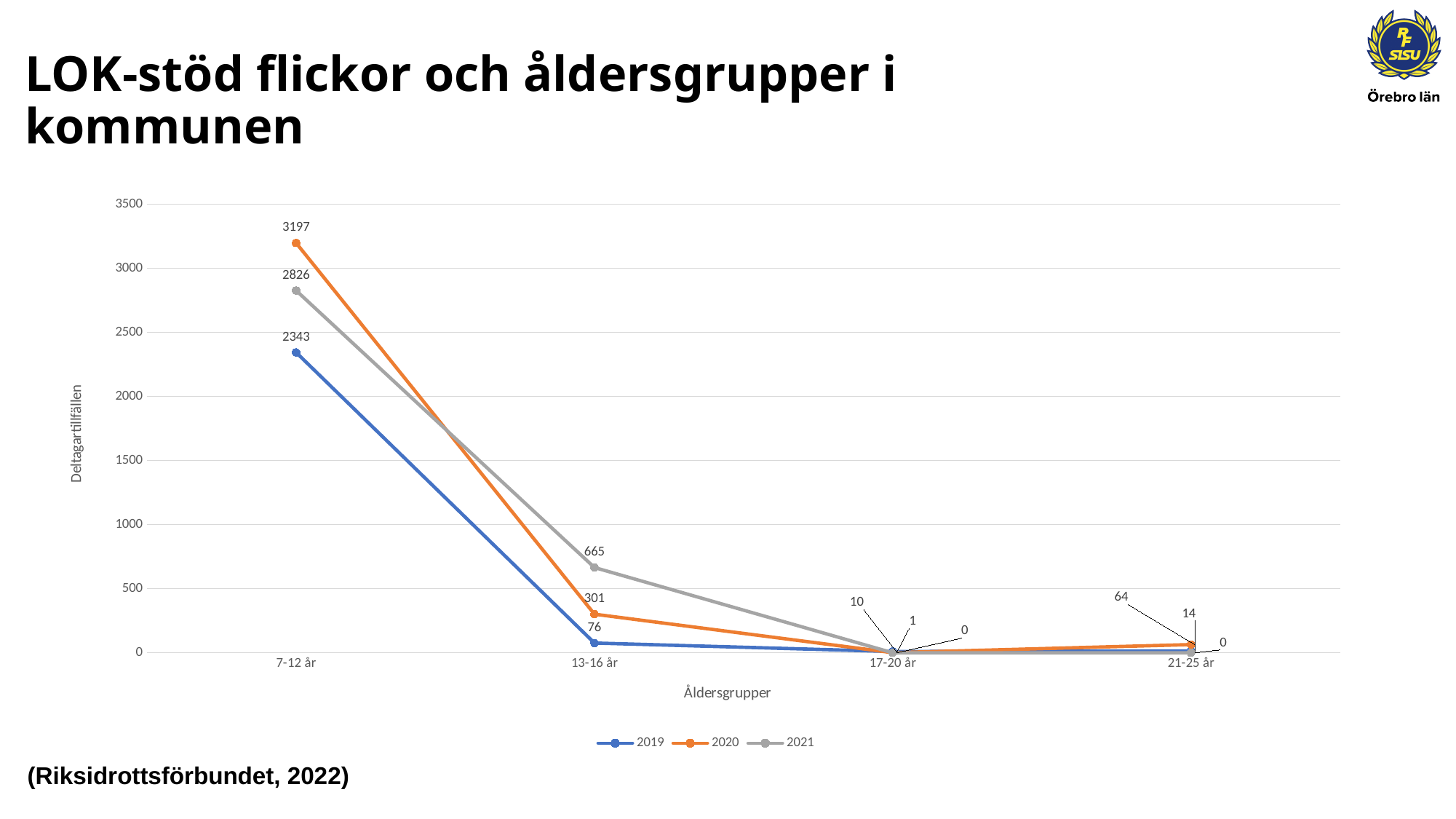
What is the value for the 2020 series at 13-16 år? 301 What is the value for the 2019 series at 7-12 år? 2343 Is the value for 2021 at 7-12 år greater or less than 2500? greater Which series has the lowest value at 13-16 år? 2019 What is the difference between the 2020 and 2021 values at 7-12 år? 371 At 13-16 år, which is larger: the 2021 value or the 2019 value? 2021 What is the value for the 2021 series at 13-16 år? 665 How many age groups are shown on the x axis? 4 How many series does the legend list? 3 Which series has the highest value at 7-12 år? 2020 What kind of chart is shown on the slide? line chart What is the value for the 2020 series at 7-12 år? 3197